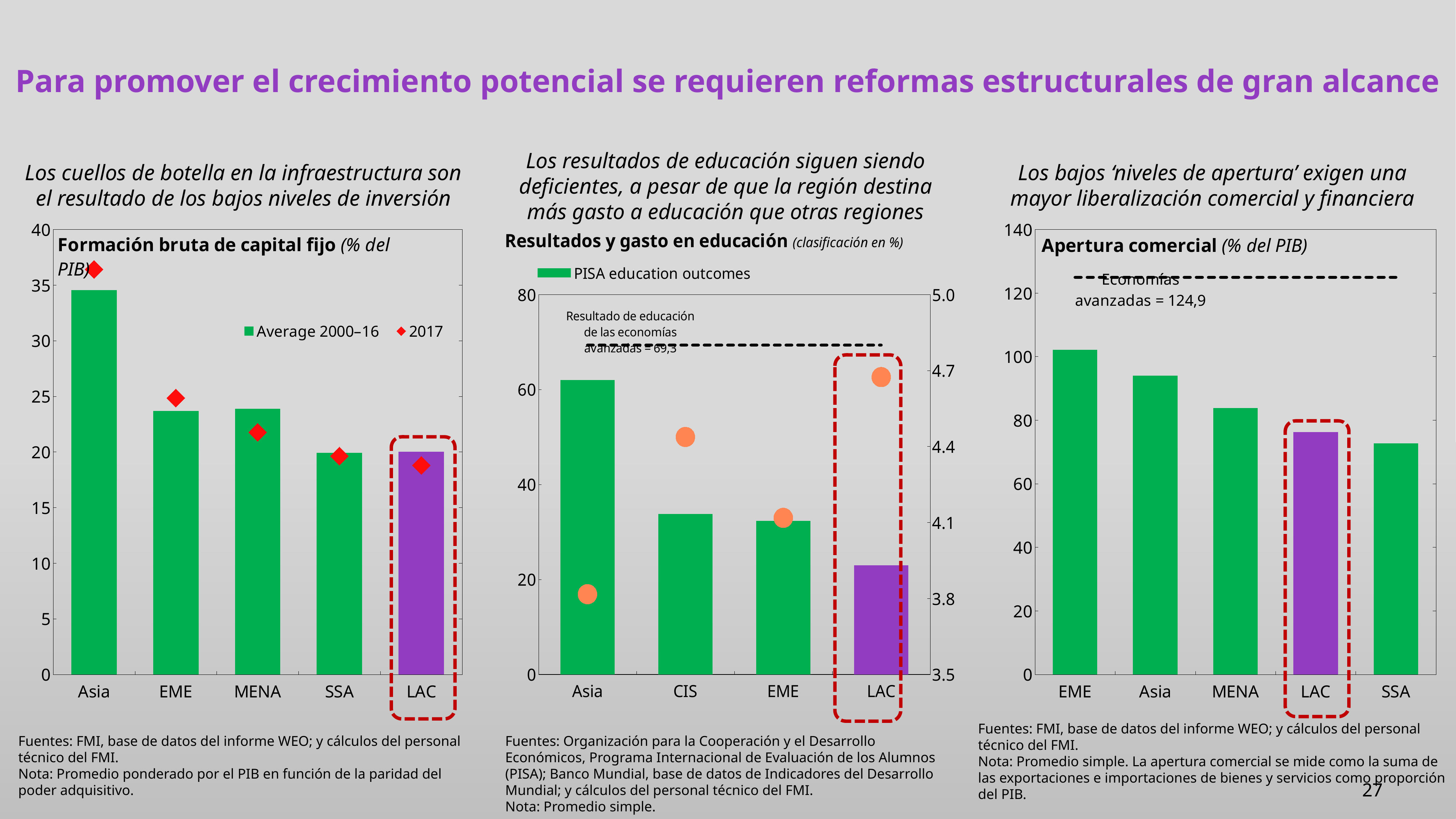
In the chart titled 'Formación bruta de capital fijo', how many series does the legend list? 2 In the chart titled 'Apertura comercial', do the bar values rise or fall from left to right along the x axis? fall In the chart titled 'Apertura comercial', what is the value for advanced economies shown by the dashed line? 124,9 In the chart titled 'Formación bruta de capital fijo', is the Average 2000–16 bar for Asia greater or less than 30? greater In the chart titled 'Formación bruta de capital fijo', which region has the highest bar for Average 2000–16? Asia In the chart titled 'Formación bruta de capital fijo', is the Average 2000–16 bar for LAC greater or less than 25? less In the chart titled 'Resultados y gasto en educación', which region has the highest PISA education outcomes bar? Asia In the chart titled 'Apertura comercial', which region has the highest bar? EME In the chart titled 'Resultados y gasto en educación', what is the education outcome value of the advanced economies shown by the dashed line? 69,3 In the chart titled 'Resultados y gasto en educación', how many regions are shown on the x axis? 4 In the chart titled 'Resultados y gasto en educación', which region has the lowest PISA education outcomes bar? LAC In the chart titled 'Formación bruta de capital fijo', how many regions are shown on the x axis? 5